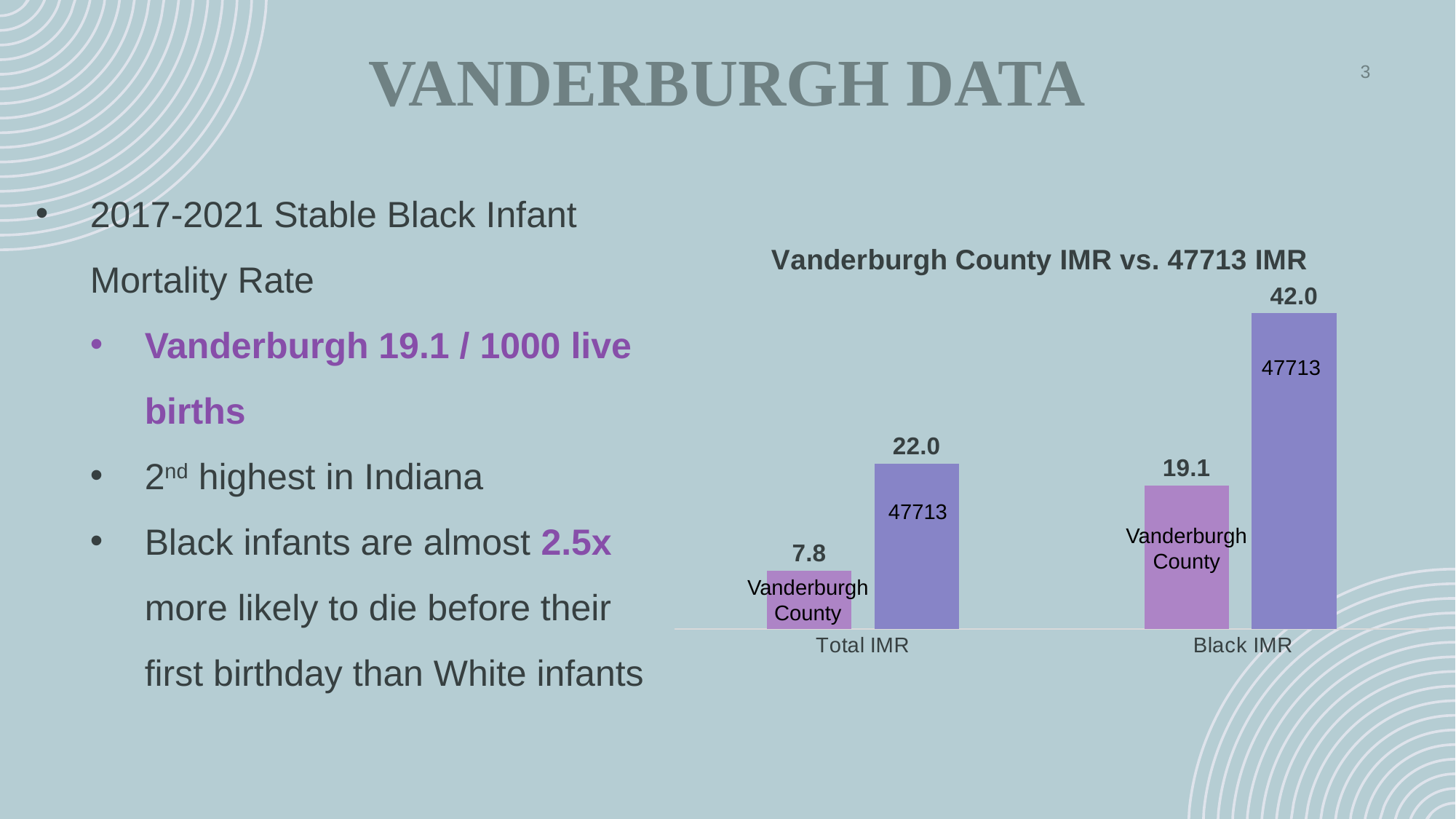
What is the Vanderburgh County value for Total IMR? 7.8 What is the Vanderburgh County value for Black IMR? 19.1 What is the 47713 value for Black IMR? 42.0 What is the difference between the 47713 and Vanderburgh County values for Total IMR? 14.2 What is the title of the chart? Vanderburgh County IMR vs. 47713 IMR Which bar has the highest value in the chart? 47713, Black IMR What is the difference between the 47713 and Vanderburgh County values for Black IMR? 22.9 What type of chart is shown on the slide? Bar chart Which bar has the lowest value in the chart? Vanderburgh County, Total IMR Which is larger for Total IMR: Vanderburgh County or 47713? 47713 What is the 47713 value for Total IMR? 22.0 How many categories are shown on the x axis of the chart? 2